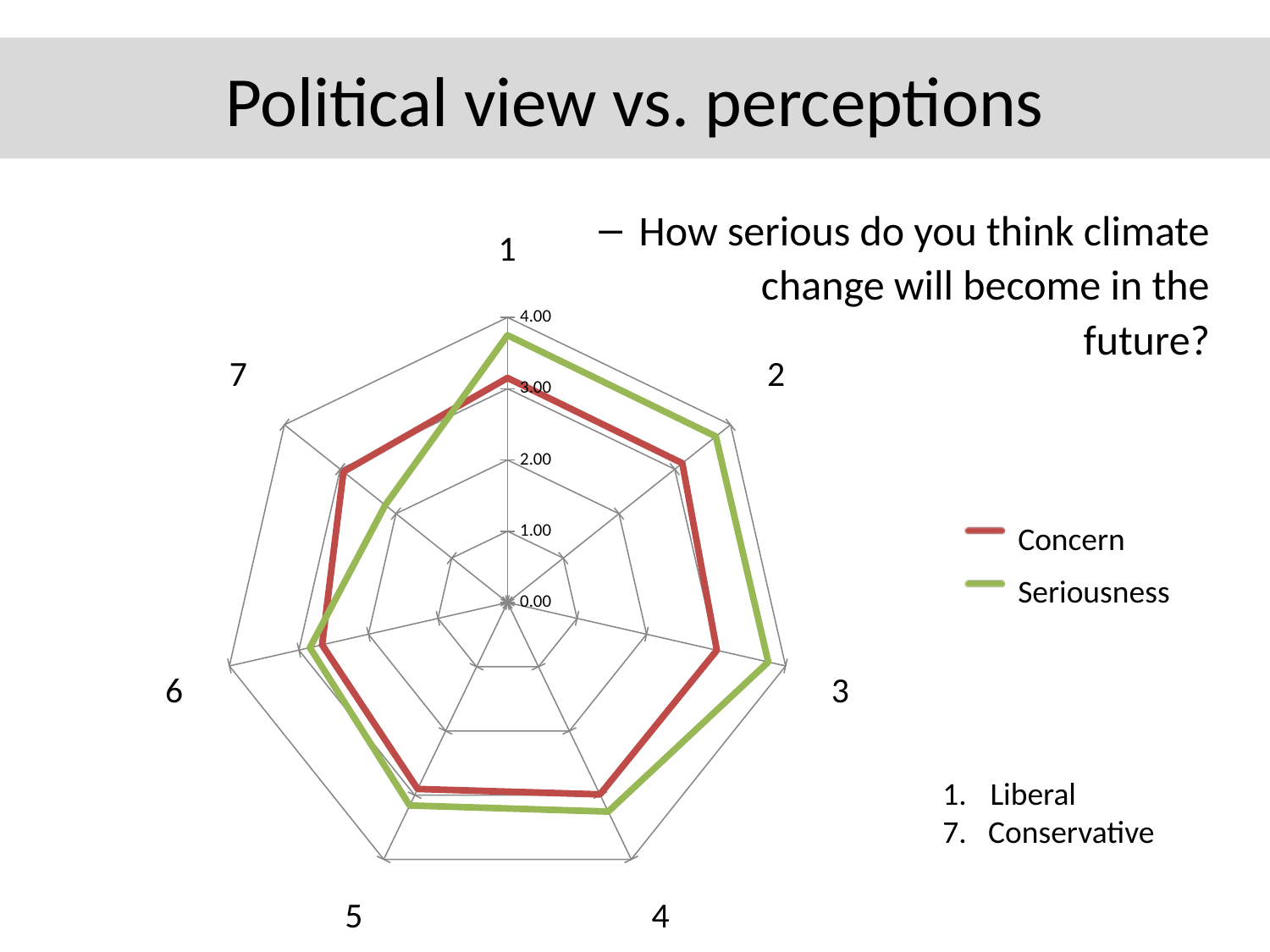
Is the Seriousness value for category 3 greater or less than 3.00? greater At category 1, which series has the larger value, Concern or Seriousness? Seriousness What is the highest value shown on the radar chart's axis scale? 4.00 For the Seriousness series, which category has the lowest value? 7 Is the Seriousness value for category 6 greater or less than 2.00? greater How many series does the legend list? 2 Is the Seriousness value for category 1 greater or less than 3.00? greater Which series is drawn in green? Seriousness How many categories (political view points) are plotted around the radar chart? 7 At category 7, which series has the larger value, Concern or Seriousness? Concern What kind of chart is shown on the slide? Radar chart